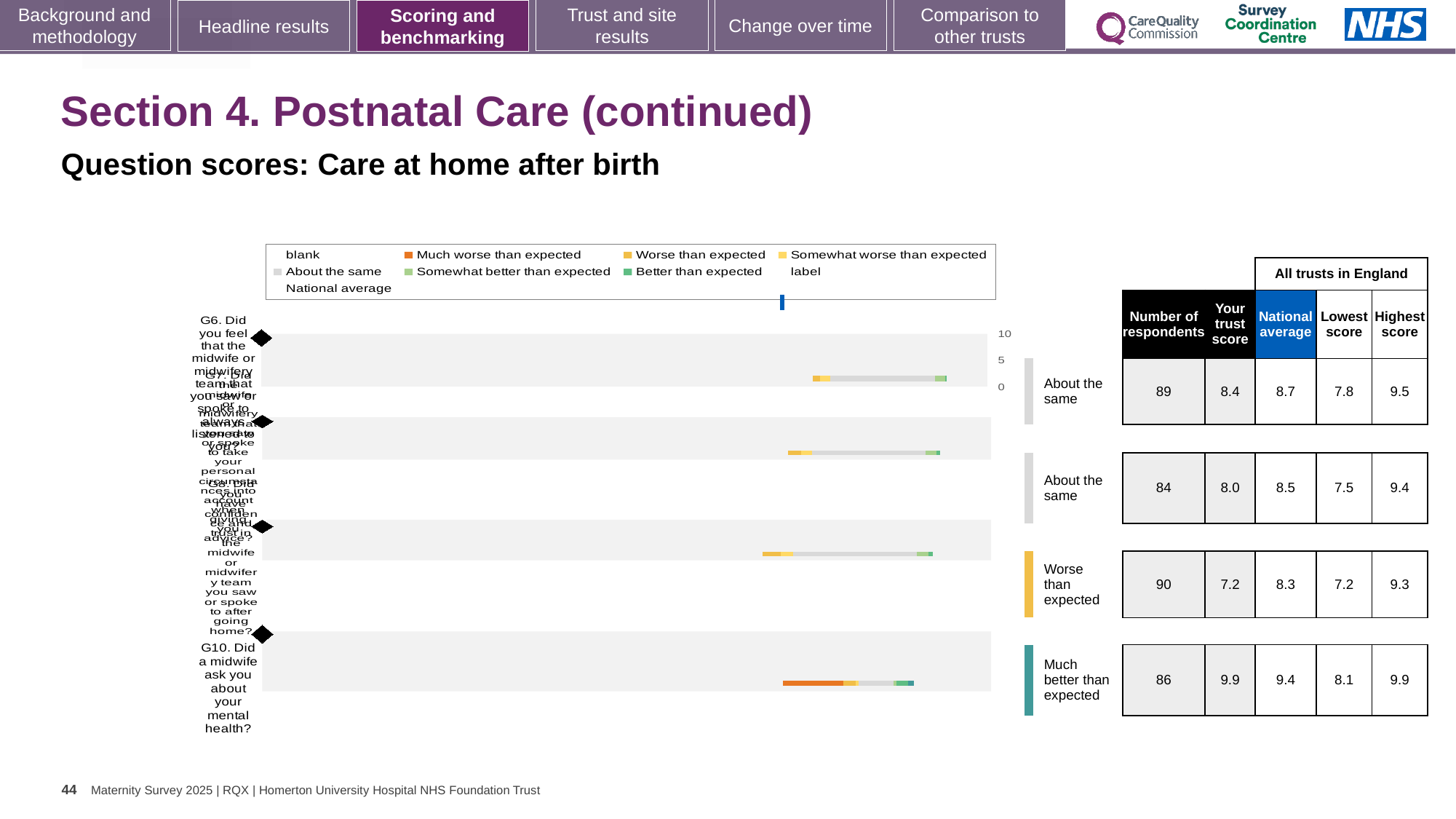
Which legend entry is shown in orange? Much worse than expected What is the difference between the trust score and the national average for question G10? 0.5 What is the national average for question G10 (Did a midwife ask you about your mental health?)? 9.4 For question G10, which is larger: the trust score or the national average? the trust score What benchmark category is given for question G10 (Did a midwife ask you about your mental health?)? Much better than expected What is the trust score for question G10 (Did a midwife ask you about your mental health?)? 9.9 How many respondents answered question G10 (Did a midwife ask you about your mental health?)? 86 What kind of chart is shown on the slide? bar chart What is the trust score for the question rated 'Worse than expected'? 7.2 What is the lowest 'Your trust score' value shown in the table? 7.2 How many survey questions (bars) are plotted in the chart? 4 What is the subtitle describing the chart's content? Question scores: Care at home after birth